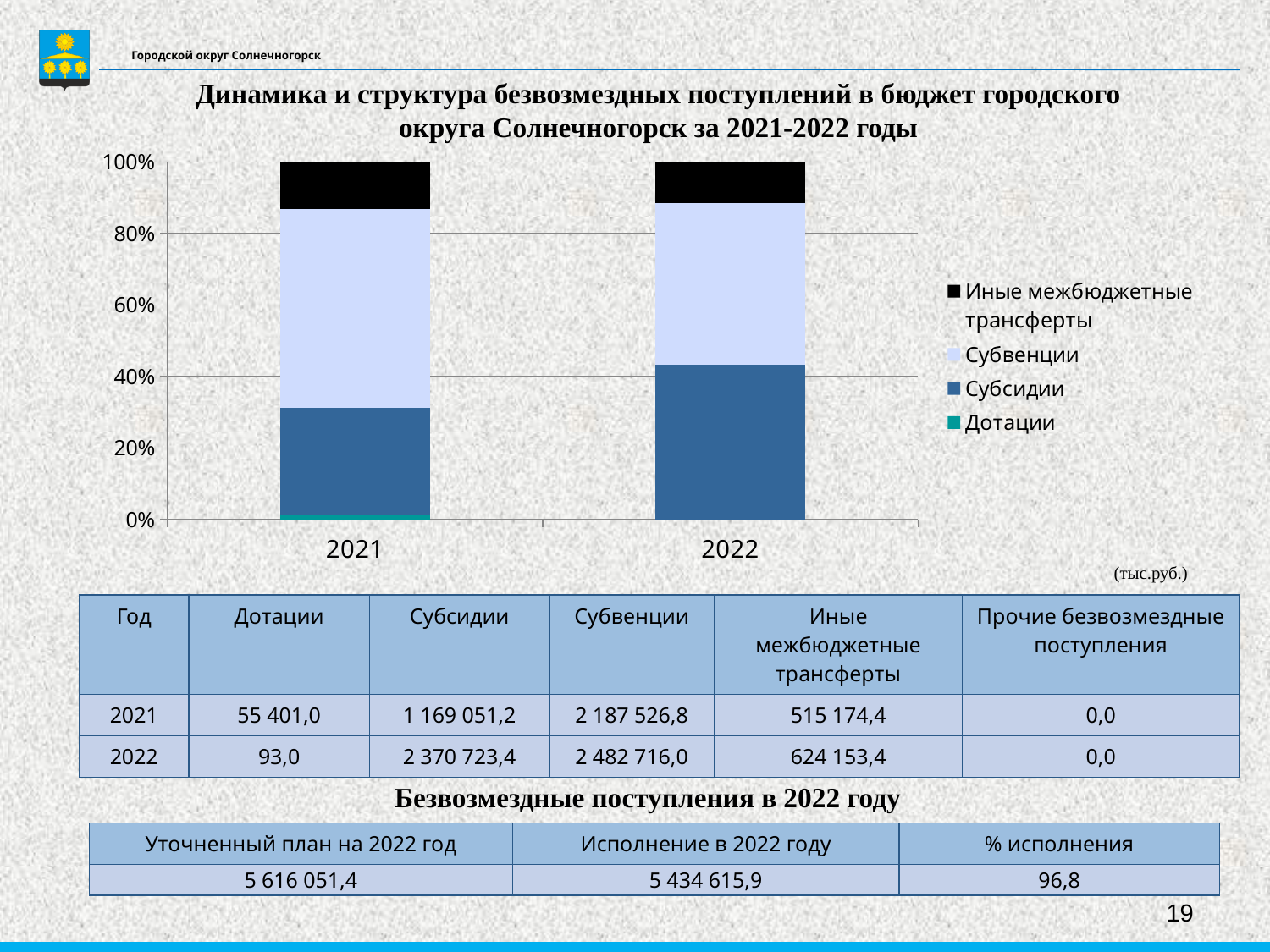
How many series does the chart legend list? 4 What kind of chart is shown on the slide? Stacked bar chart Which series has the largest share of the 2021 bar? Субвенции Is the share of Субсидии larger in 2021 or in 2022? 2022 Which series is shown in green at the bottom of the bars? Дотации Is the share of Субсидии in 2021 greater or less than 40%? less Does the share of Субсидии rise or fall from 2021 to 2022? rise Which series is shown in black in the chart? Иные межбюджетные трансферты Is the share of Иные межбюджетные трансферты in 2021 greater or less than 20%? less Is the share of Субсидии in 2022 greater or less than 40%? greater Which series has the smallest share of the 2021 bar? Дотации How many years (categories) are shown on the x axis of the chart? 2